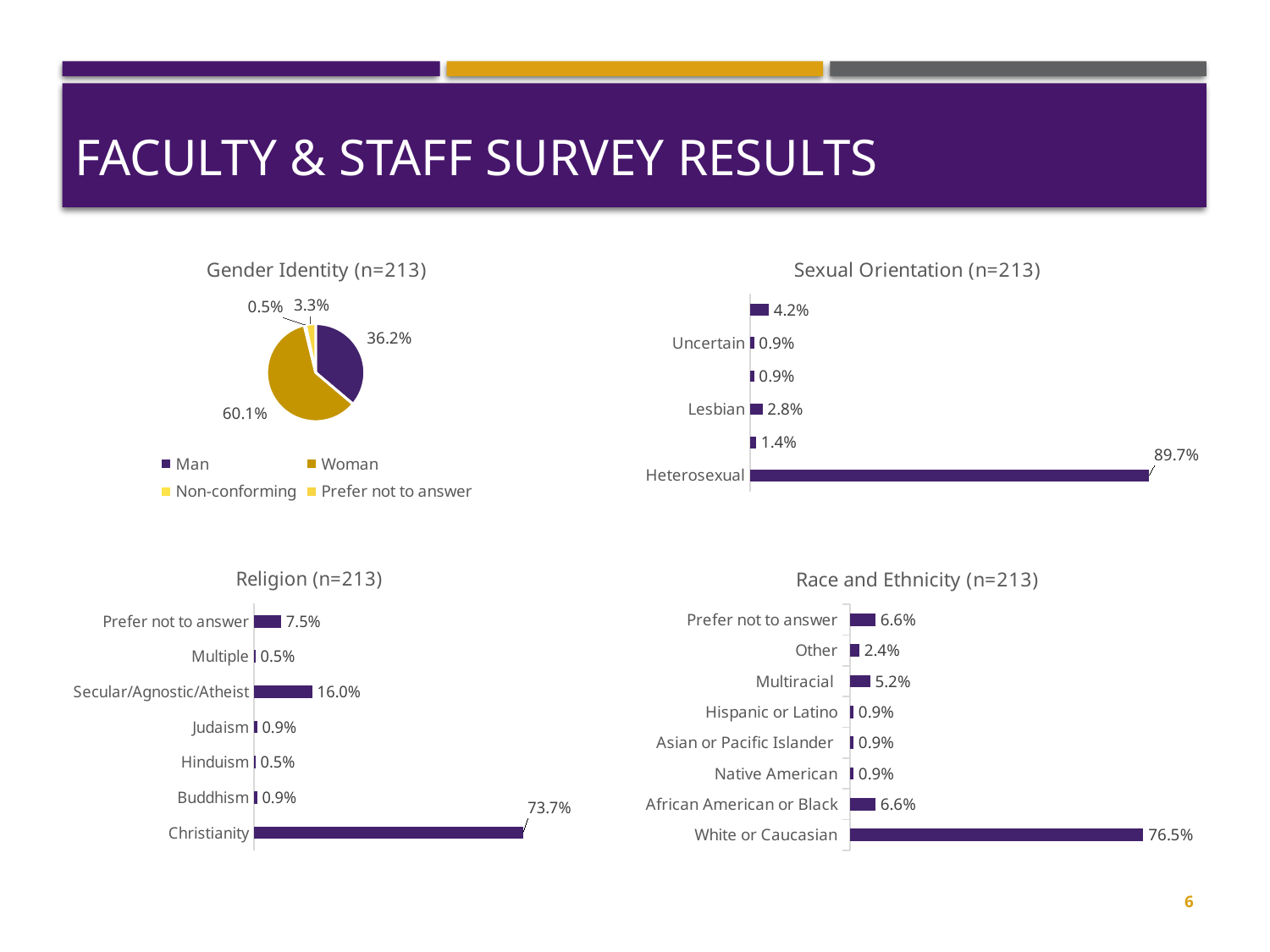
How many entries does the legend of the Gender Identity chart list? 4 In the Gender Identity chart, what percentage of respondents identified as Man? 36.2% In the Race and Ethnicity chart, what is the difference between White or Caucasian and Multiracial? 71.3% In the Religion chart, which category has the highest value? Christianity In the Religion chart, how many categories are shown? 7 In the Gender Identity chart, what percentage of respondents identified as Woman? 60.1% What kind of chart is the Race and Ethnicity chart? Bar chart In the Sexual Orientation chart, what is the value for Lesbian? 2.8% In the Race and Ethnicity chart, which is larger: Other or Prefer not to answer? Prefer not to answer In the Sexual Orientation chart, what is the value for Heterosexual? 89.7% In the Religion chart, what is the value for Secular/Agnostic/Atheist? 16.0% What kind of chart is the Gender Identity chart? Pie chart